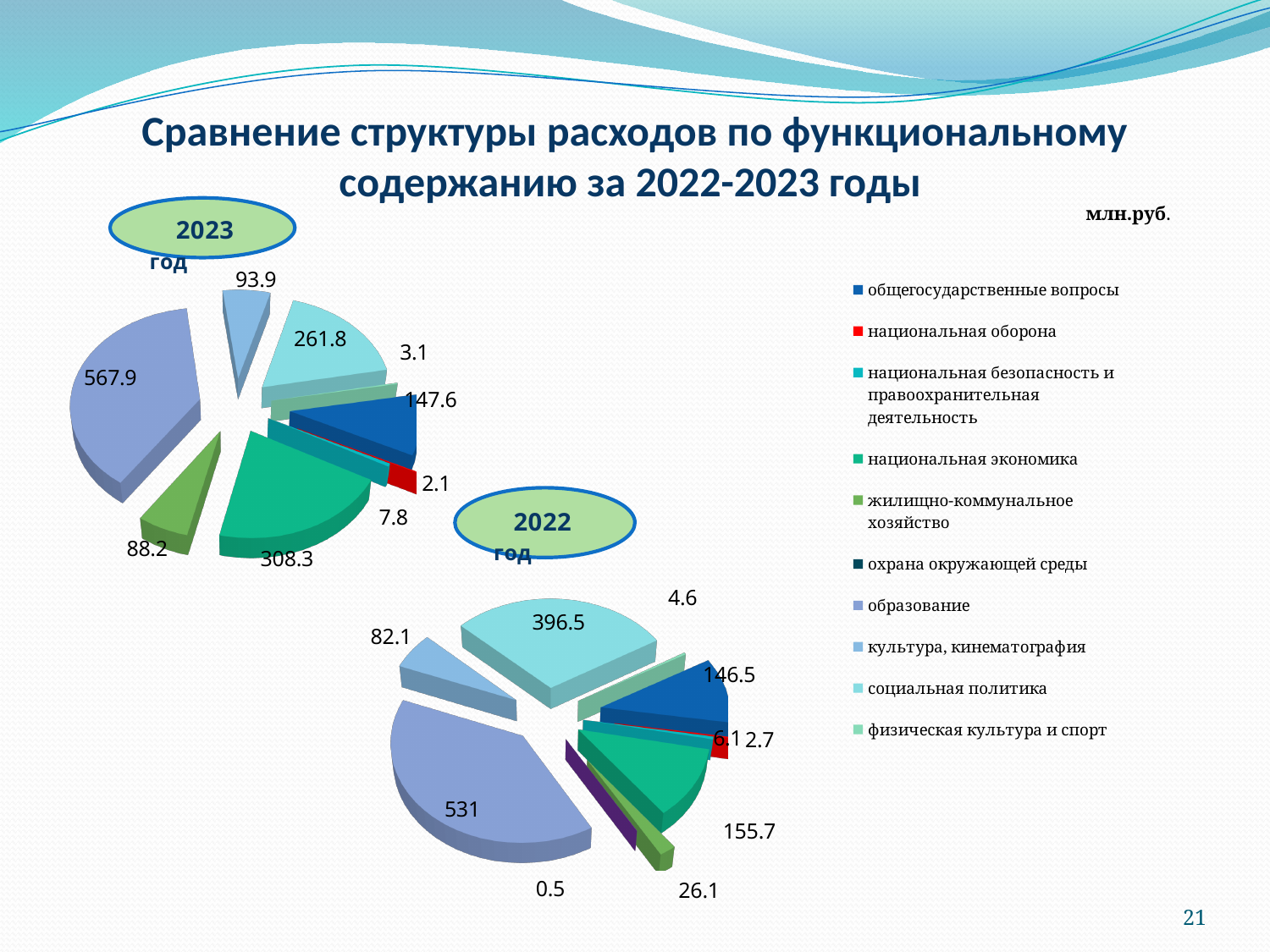
In the 2023 год chart, what is the smallest value shown? 2.1 How many categories does the legend list? 10 In the 2022 год chart, what is the largest value shown? 531 In the 2023 год chart, what is the largest value shown? 567.9 What unit is stated for the values on the slide? млн.руб. Which is larger: социальная политика in the 2022 год chart or in the 2023 год chart? 2022 год What type of charts are shown on the slide? Pie charts In the 2023 год chart, what is the value for национальная экономика? 308.3 What is the difference between the образование values in the 2023 год chart (567.9) and the 2022 год chart (531)? 36.9 In the 2023 год chart, what is the value for образование? 567.9 In the 2022 год chart, what is the smallest value shown? 0.5 In the 2022 год chart, what is the value for социальная политика? 396.5